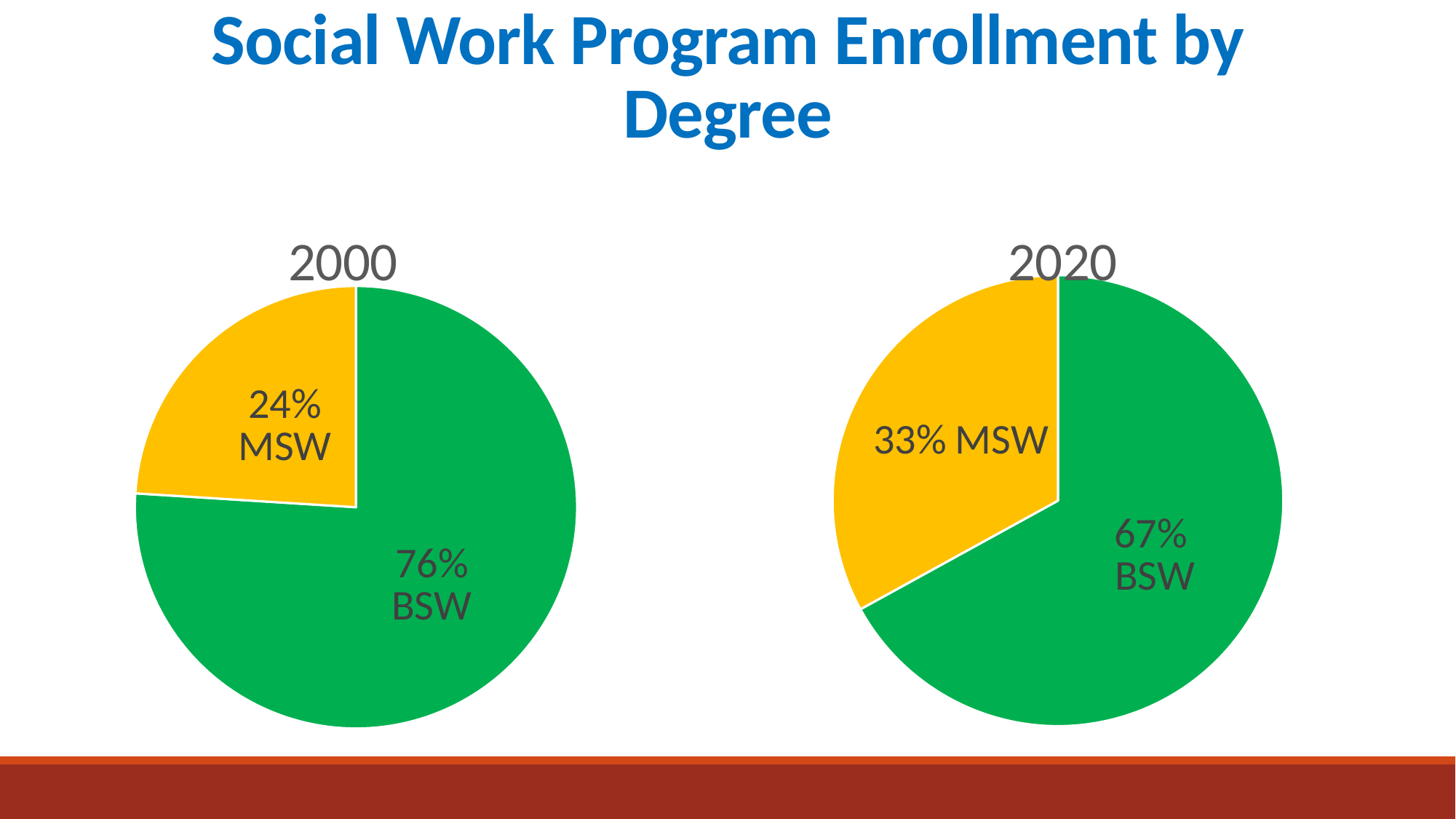
In the 2000 pie chart, what share of enrollment is BSW? 76% In the 2000 pie chart, what is the difference between the BSW and MSW shares? 52% In the 2020 pie chart, what share of enrollment is BSW? 67% In the 2000 pie chart, which degree has the largest share? BSW In the 2020 pie chart, what is the difference between the BSW and MSW shares? 34% In the 2020 pie chart, which degree has the smallest share? MSW What is the title of the slide? Social Work Program Enrollment by Degree In the 2000 pie chart, what share of enrollment is MSW? 24% Is the MSW share larger in the 2000 chart or the 2020 chart? 2020 How many slices does the 2020 pie chart have? 2 In the 2020 pie chart, what share of enrollment is MSW? 33% What type of chart is used on this slide? Pie chart